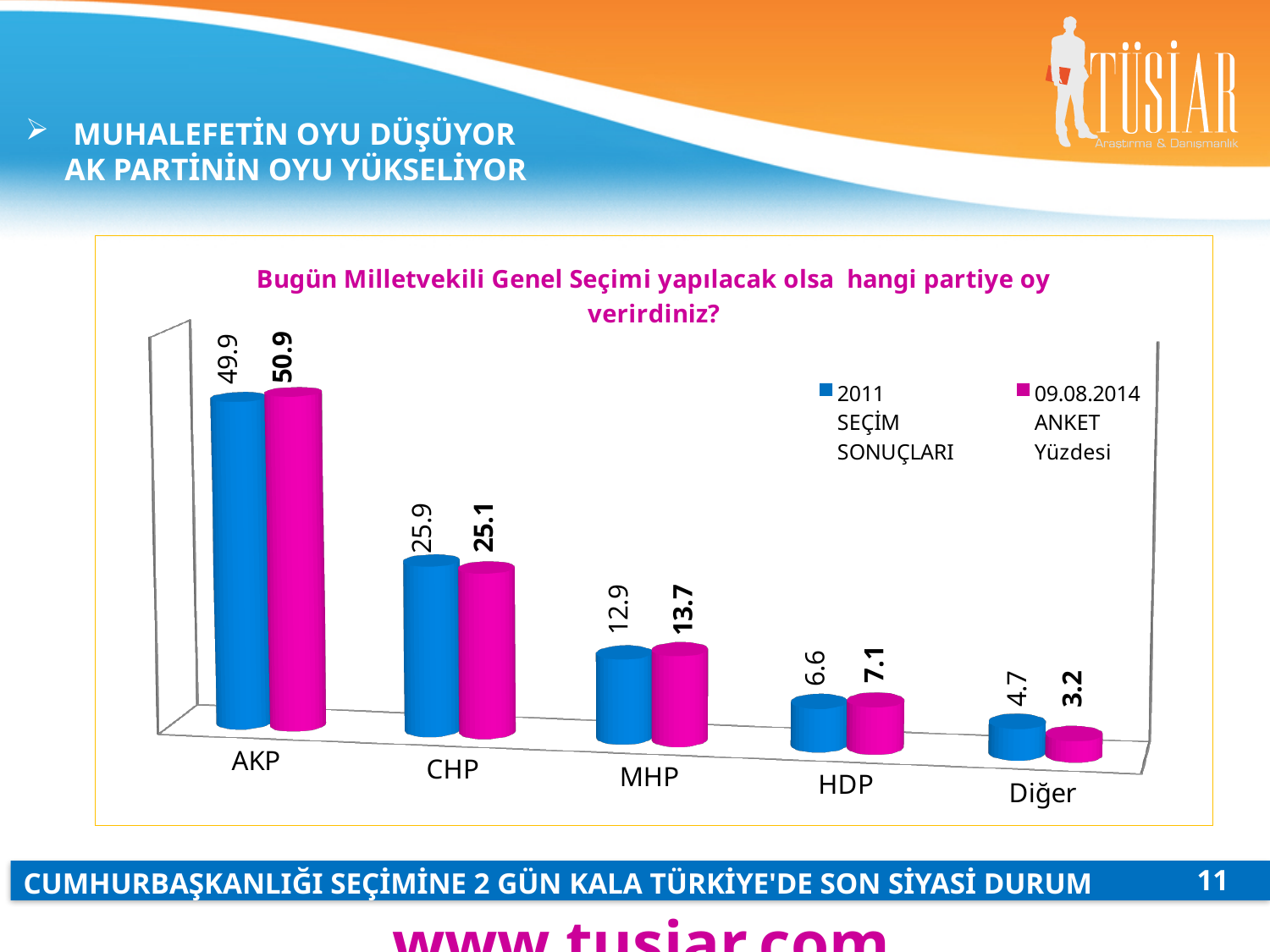
Which category has the lowest 09.08.2014 ANKET Yüzdesi value? Diğer What is the 2011 SEÇİM SONUÇLARI value for HDP? 6.6 How many parties/categories are shown on the x axis? 5 What colour are the bars for the 09.08.2014 ANKET Yüzdesi series? Magenta (pink) Which party has the highest 09.08.2014 ANKET Yüzdesi value? AKP What is the 09.08.2014 ANKET Yüzdesi value for CHP? 25.1 How many series does the legend list? 2 What is the 2011 SEÇİM SONUÇLARI value for AKP? 49.9 What kind of chart is shown on the slide? Bar chart Which is larger for Diğer: the 2011 SEÇİM SONUÇLARI value or the 09.08.2014 ANKET Yüzdesi value? 2011 SEÇİM SONUÇLARI What is the difference between the 09.08.2014 ANKET Yüzdesi and 2011 SEÇİM SONUÇLARI values for AKP? 1.0 What is the 09.08.2014 ANKET Yüzdesi value for MHP? 13.7